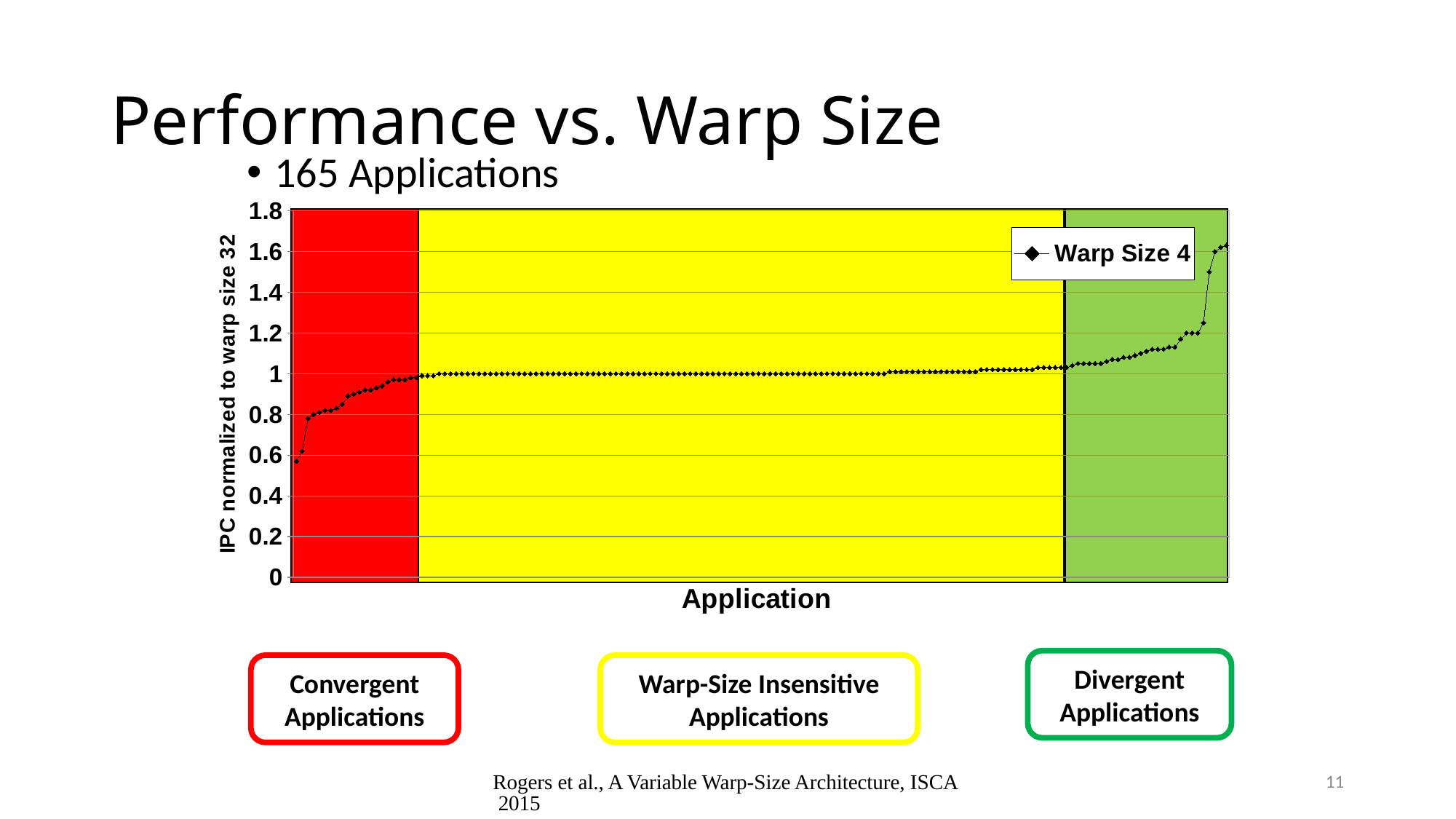
Is the value of the rightmost point in the chart greater or less than 1.8? less What is the title of the y axis of the chart? IPC normalized to warp size 32 Is the value of the rightmost point in the chart greater or less than 1.4? greater How many series does the chart legend list? 1 Are the values in the yellow (Warp-Size Insensitive) region greater or less than 1.2? less Which point has the higher value: the leftmost point or the rightmost point? the rightmost point Do the plotted values rise or fall from left to right along the x axis? rise What is the highest tick value shown on the y axis? 1.8 What kind of chart is shown on the slide? line chart What is the name of the series shown in the chart legend? Warp Size 4 How many applications are plotted in the chart, according to the slide? 165